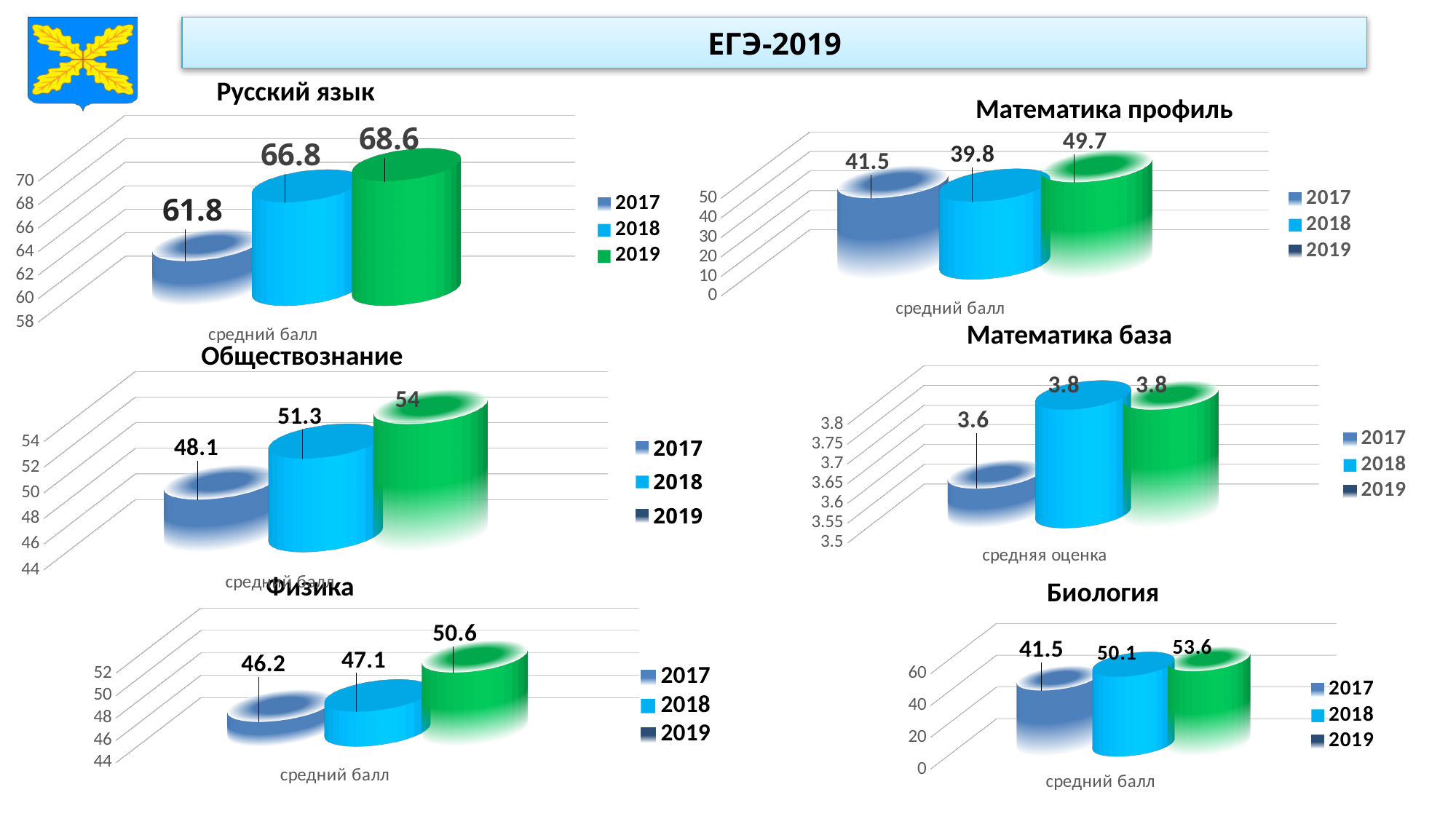
In the 'Биология' chart, do the values rise or fall from 2017 to 2019? rise In the 'Обществознание' chart, what is the value for 2018? 51.3 In the 'Физика' chart, what is the difference between the 2019 and 2018 values? 3.5 In the 'Математика база' chart, how many series does the legend list? 3 In the 'Математика база' chart, what is the value for 2017? 3.6 In the 'Биология' chart, which is larger, the value for 2017 or the value for 2018? 2018 In the 'Русский язык' chart, what is the value for 2019? 68.6 In the 'Математика профиль' chart, what is the value for 2019? 49.7 In the 'Русский язык' chart, what is the difference between the 2019 and 2017 values? 6.8 In the 'Обществознание' chart, which year has the highest value? 2019 What kind of chart is the 'Физика' chart? bar chart In the 'Математика профиль' chart, which year has the lowest value? 2018